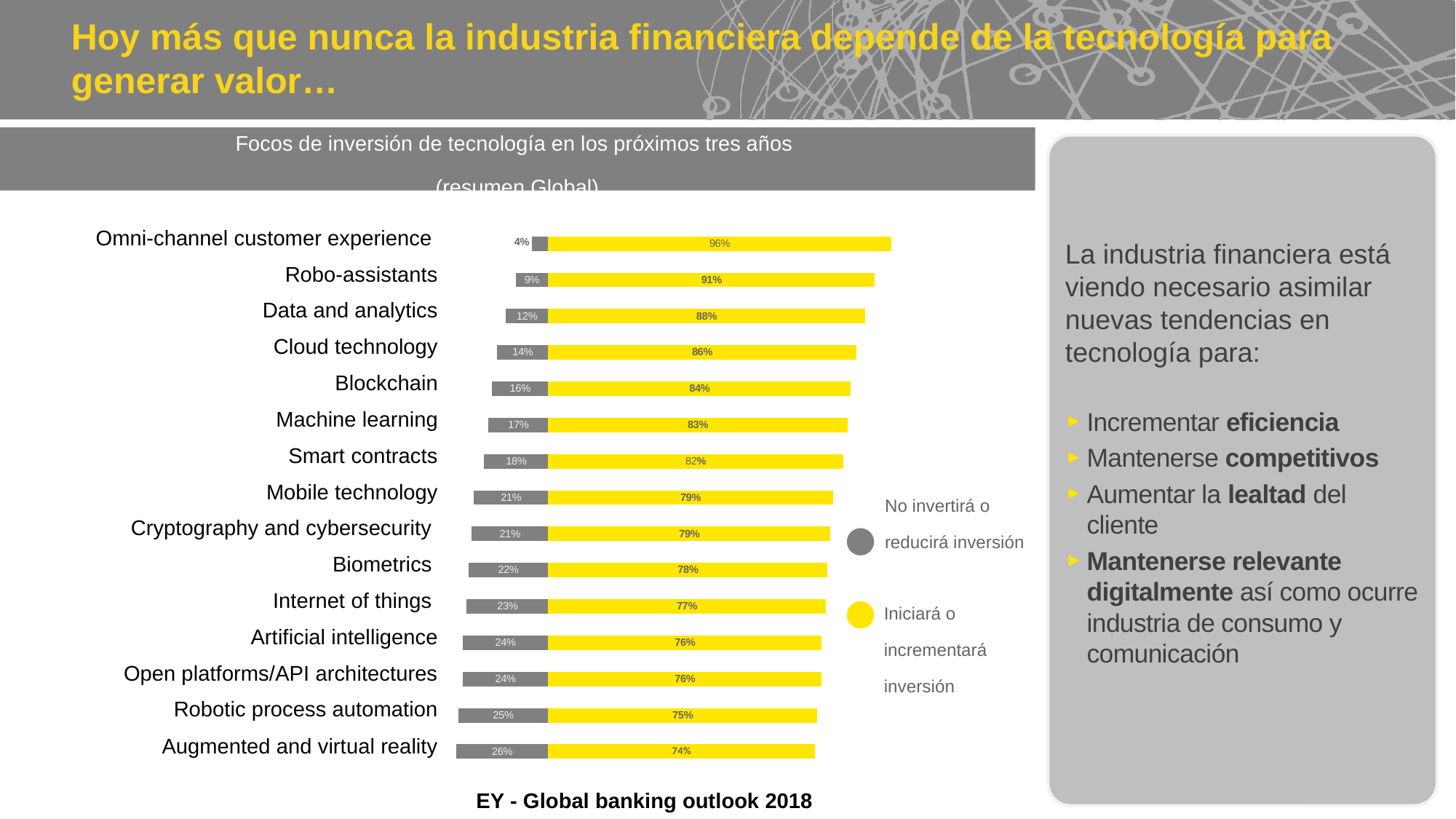
Which technology has the lowest share of respondents who will start or increase investment? Augmented and virtual reality What percentage of respondents will start or increase investment ("Iniciará o incrementará inversión") in Omni-channel customer experience? 96% How many technology categories are shown in the chart? 15 What is the "Iniciará o incrementará inversión" value for Artificial intelligence? 76% What kind of chart is shown on the slide? Stacked bar chart What percentage will not invest or will reduce investment ("No invertirá o reducirá inversión") in Blockchain? 16% Which technology has the highest share of respondents who will start or increase investment? Omni-channel customer experience What is the total of the two segments for the Machine learning bar? 100% What is the difference between the "Iniciará o incrementará inversión" values for Robo-assistants and Cloud technology? 5% How many series does the legend list? 2 Which has a larger "No invertirá o reducirá inversión" share: Data and analytics or Internet of things? Internet of things Which colour represents "Iniciará o incrementará inversión" in the chart? Yellow